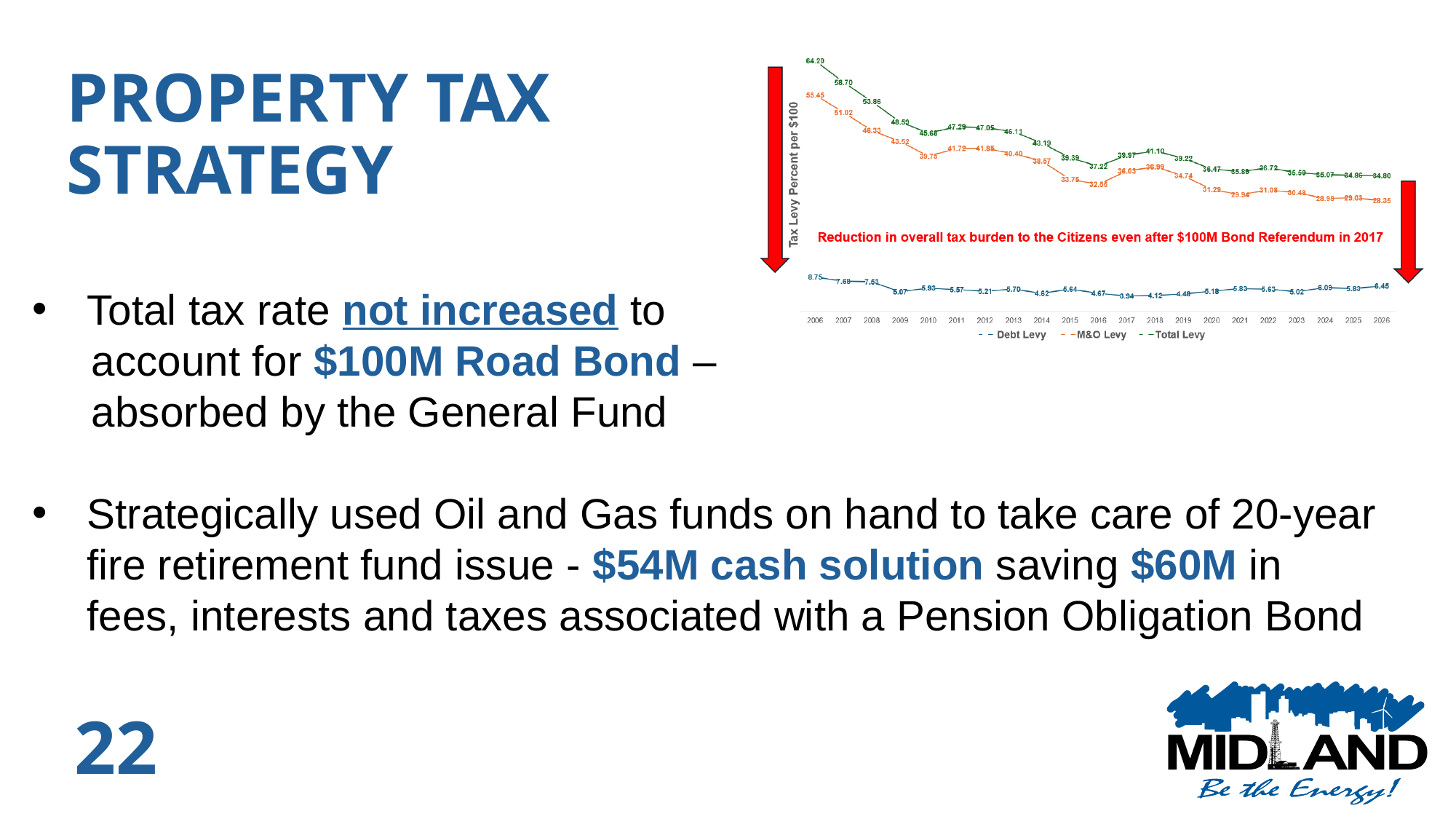
What are the three series named in the chart legend? Debt Levy, M&O Levy, Total Levy What kind of chart is shown on the slide? line chart What is the Total Levy value for 2006? 64.20 By how much did the Total Levy fall from 2006 to 2026? 29.40 How many series does the chart legend list? 3 What is the M&O Levy value for 2006? 55.45 What is the Total Levy value for 2026? 34.80 How many years are shown along the x axis of the chart? 21 What is the M&O Levy value for 2026? 28.35 What is the Debt Levy value for 2006? 8.75 Which year has the highest Total Levy value? 2006 Does the Total Levy generally rise or fall from 2006 to 2026? fall